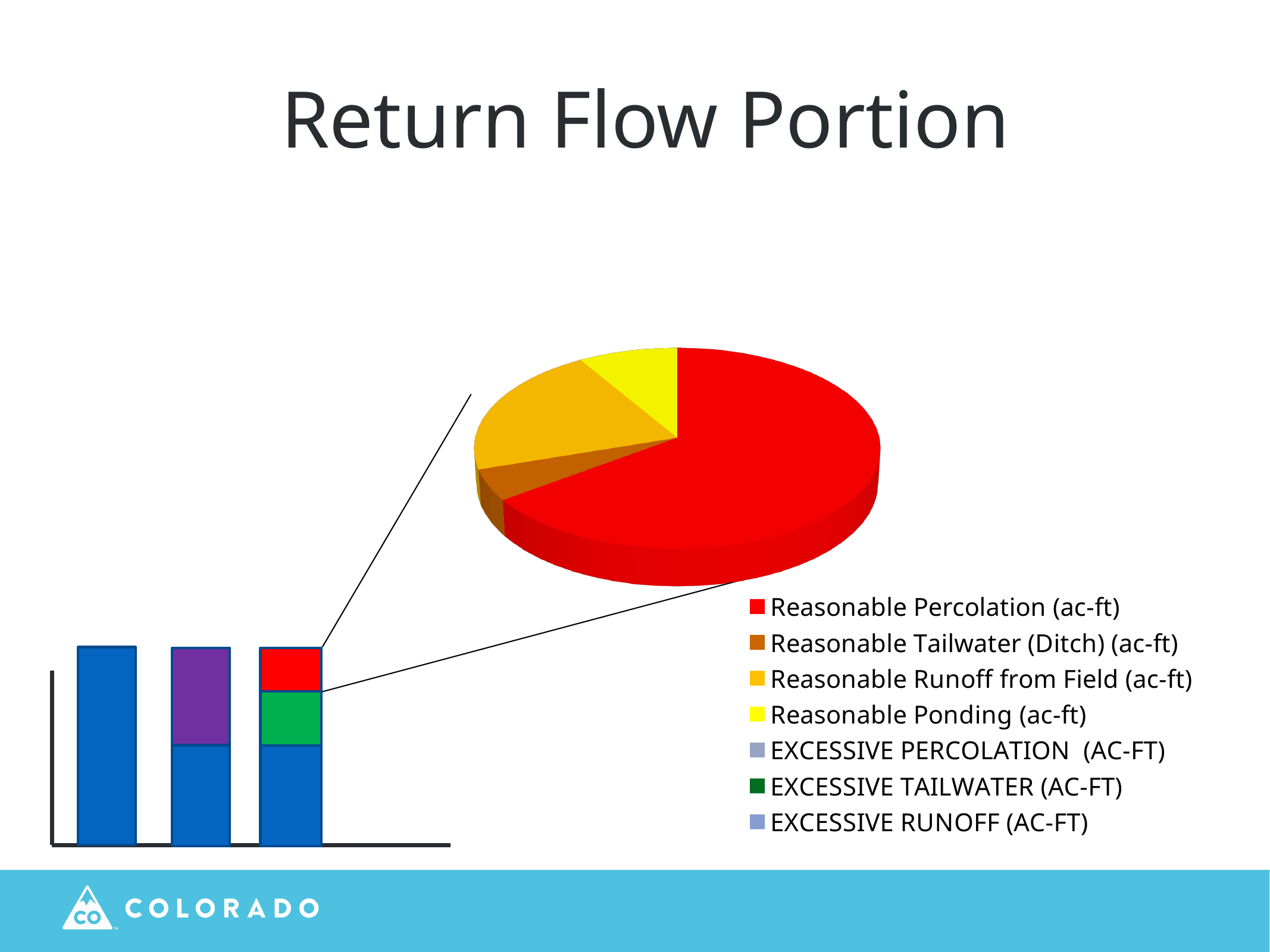
What kind of chart is the chart at the top right of the slide? pie chart In the pie chart legend, what colour represents Reasonable Ponding (ac-ft)? yellow What kind of chart is the chart at the bottom left of the slide? bar chart In the pie chart, which category has the smallest visible slice? Reasonable Tailwater (Ditch) (ac-ft) How many slices are visible in the pie chart? 4 How many entries does the legend next to the pie chart list? 7 What is the title of the slide? Return Flow Portion How many bars are in the bar chart at the bottom left of the slide? 3 In the pie chart, which slice is larger: Reasonable Percolation (ac-ft) or Reasonable Runoff from Field (ac-ft)? Reasonable Percolation (ac-ft) In the pie chart, which slice is larger: Reasonable Runoff from Field (ac-ft) or Reasonable Ponding (ac-ft)? Reasonable Runoff from Field (ac-ft) In the pie chart, which category has the largest slice? Reasonable Percolation (ac-ft)